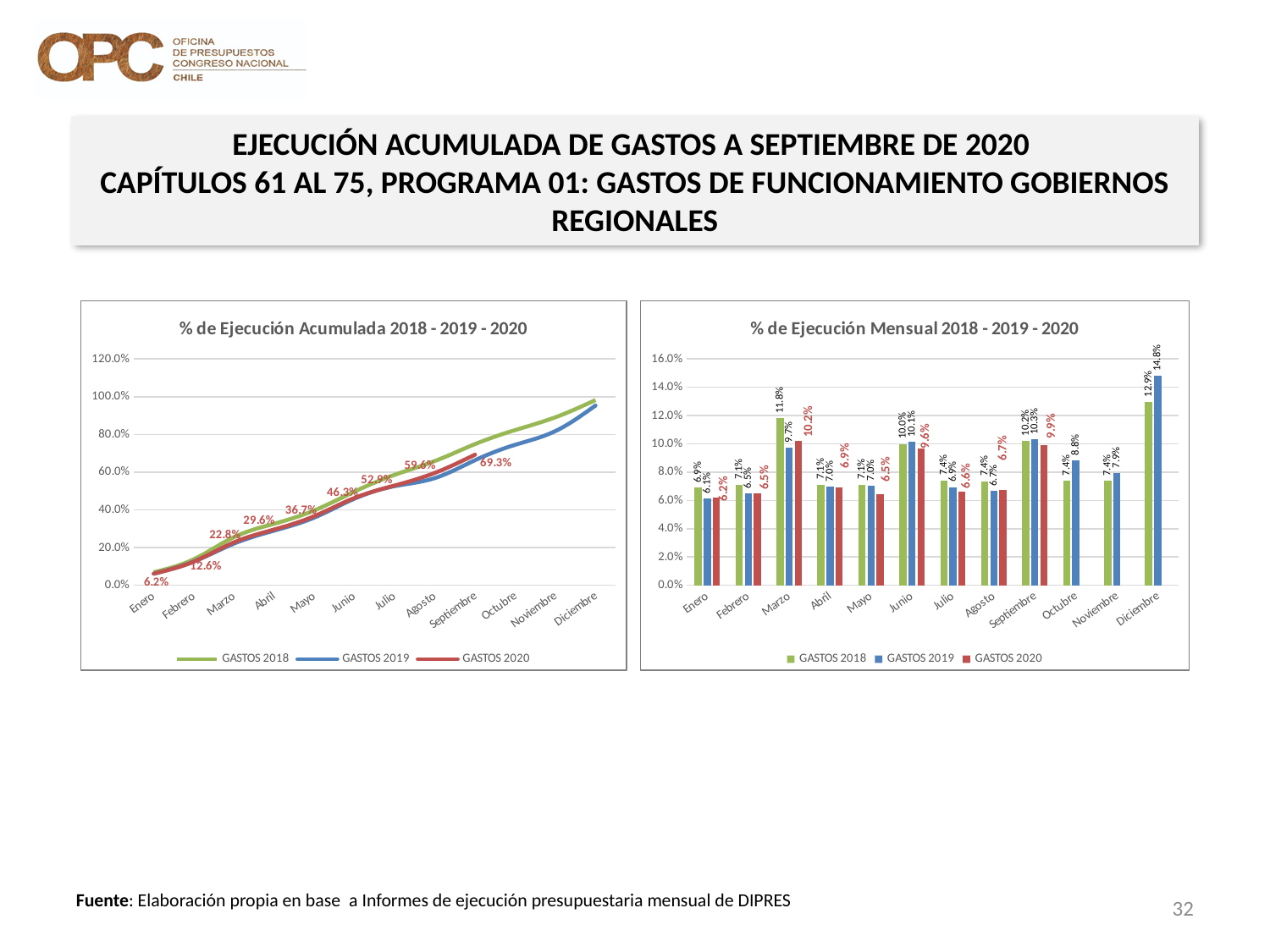
In the chart titled '% de Ejecución Mensual 2018 - 2019 - 2020', which month has the highest GASTOS 2018 value? Diciembre What kind of chart is the chart titled '% de Ejecución Acumulada 2018 - 2019 - 2020'? line chart In the chart titled '% de Ejecución Mensual 2018 - 2019 - 2020', which month has the lowest GASTOS 2020 value? Enero In the chart titled '% de Ejecución Mensual 2018 - 2019 - 2020', what is the GASTOS 2019 value for Diciembre? 14.8% In the chart titled '% de Ejecución Mensual 2018 - 2019 - 2020', which is larger for Marzo: GASTOS 2018 or GASTOS 2019? GASTOS 2018 In the chart titled '% de Ejecución Acumulada 2018 - 2019 - 2020', what is the GASTOS 2020 value for Enero? 6.2% In the chart titled '% de Ejecución Acumulada 2018 - 2019 - 2020', do the GASTOS 2020 values rise or fall from Enero to Septiembre? rise In the chart titled '% de Ejecución Acumulada 2018 - 2019 - 2020', how many series does the legend list? 3 In the chart titled '% de Ejecución Mensual 2018 - 2019 - 2020', what is the GASTOS 2020 value for Marzo? 10.2% What kind of chart is the chart titled '% de Ejecución Mensual 2018 - 2019 - 2020'? bar chart In the chart titled '% de Ejecución Acumulada 2018 - 2019 - 2020', what is the difference between the GASTOS 2020 values for Septiembre and Agosto? 9.7% In the chart titled '% de Ejecución Acumulada 2018 - 2019 - 2020', what is the GASTOS 2020 value for Septiembre? 69.3%